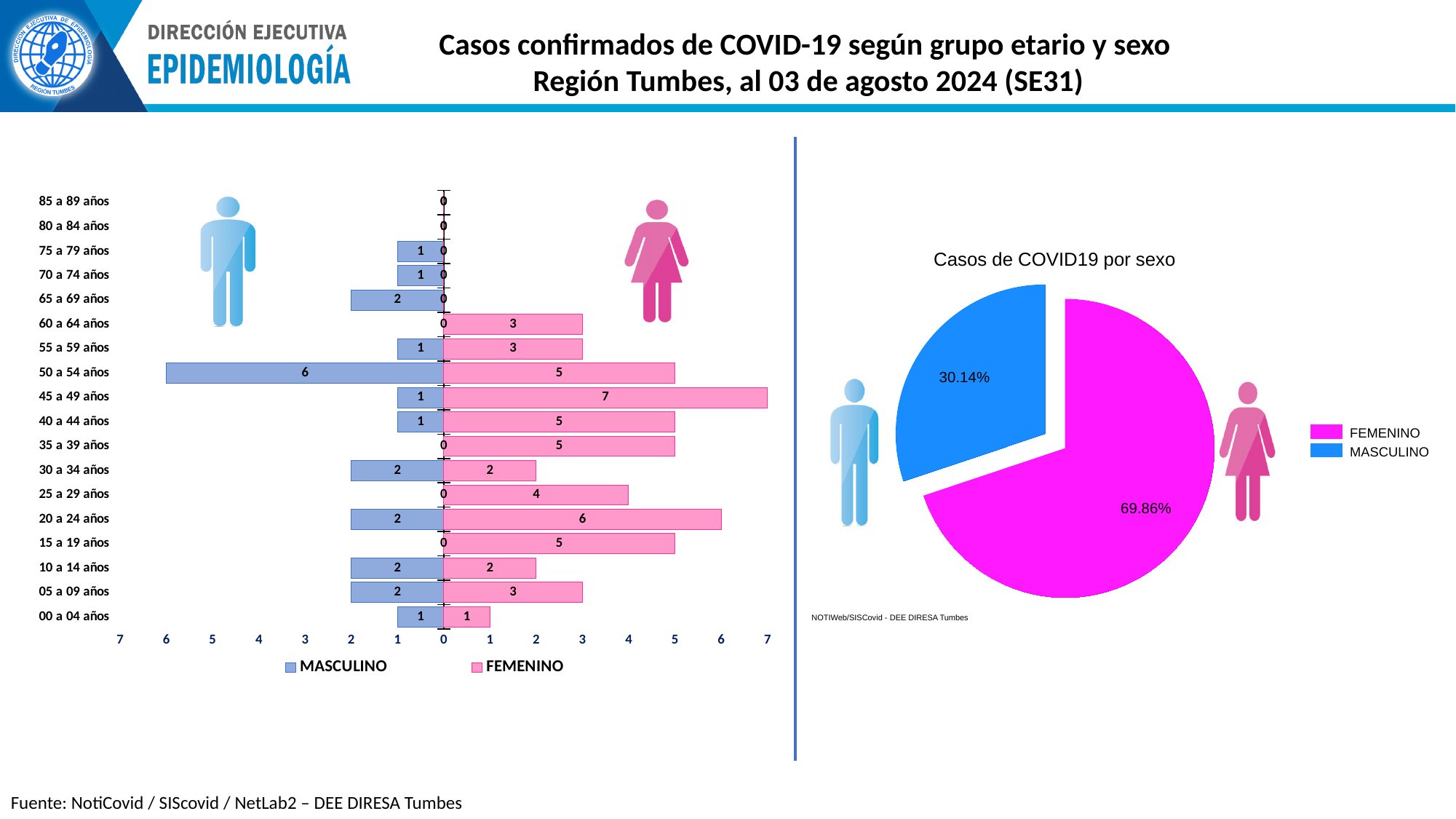
In the left bar chart, what is the difference between the FEMENINO and MASCULINO values for the 45 a 49 años group? 6 In the left bar chart, which age group has the highest MASCULINO value? 50 a 54 años In the pie chart 'Casos de COVID19 por sexo', what share is MASCULINO? 30.14% In the pie chart 'Casos de COVID19 por sexo', what share is FEMENINO? 69.86% In the left bar chart, how many series does the legend list? 2 What kind of chart is the chart titled 'Casos de COVID19 por sexo'? Pie chart In the left bar chart, which is larger for the 50 a 54 años group, MASCULINO or FEMENINO? MASCULINO In the left bar chart, which age group has the highest FEMENINO value? 45 a 49 años In the left bar chart, how many FEMENINO cases are in the 20 a 24 años group? 6 In the left bar chart, how many MASCULINO cases are in the 50 a 54 años group? 6 In the left bar chart, how many age groups are shown? 18 In the left bar chart, how many FEMENINO cases are in the 45 a 49 años group? 7